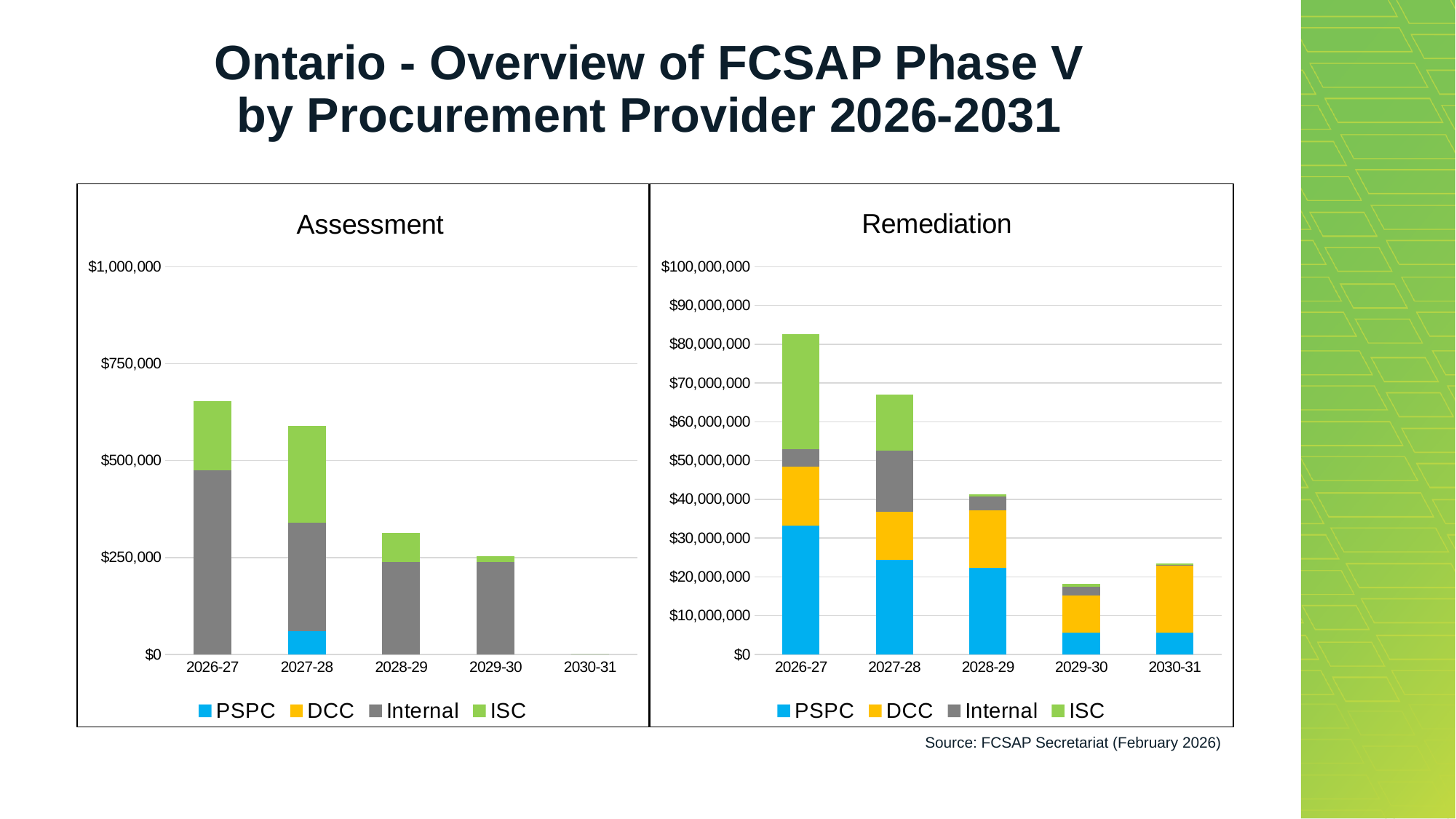
In the Remediation chart, do the stacked bar totals generally rise or fall from 2026-27 to 2029-30? fall What kind of chart is the Assessment chart? stacked bar chart In the Remediation chart, which is larger, the total for 2029-30 or the total for 2030-31? 2030-31 In the Assessment chart, which colour represents the Internal series? grey In the Assessment chart, which fiscal year has the tallest stacked bar? 2026-27 In the Remediation chart, which fiscal year has the shortest stacked bar? 2029-30 In the Assessment chart, is the total for 2026-27 greater or less than $500,000? greater How many series does the legend of the Remediation chart list? 4 How many fiscal-year categories are shown on the x axis of the Assessment chart? 5 In the Remediation chart, which fiscal year has the tallest stacked bar? 2026-27 In the Remediation chart, is the total for 2027-28 greater or less than $60,000,000? greater In the Assessment chart, is the total for 2028-29 greater or less than $500,000? less